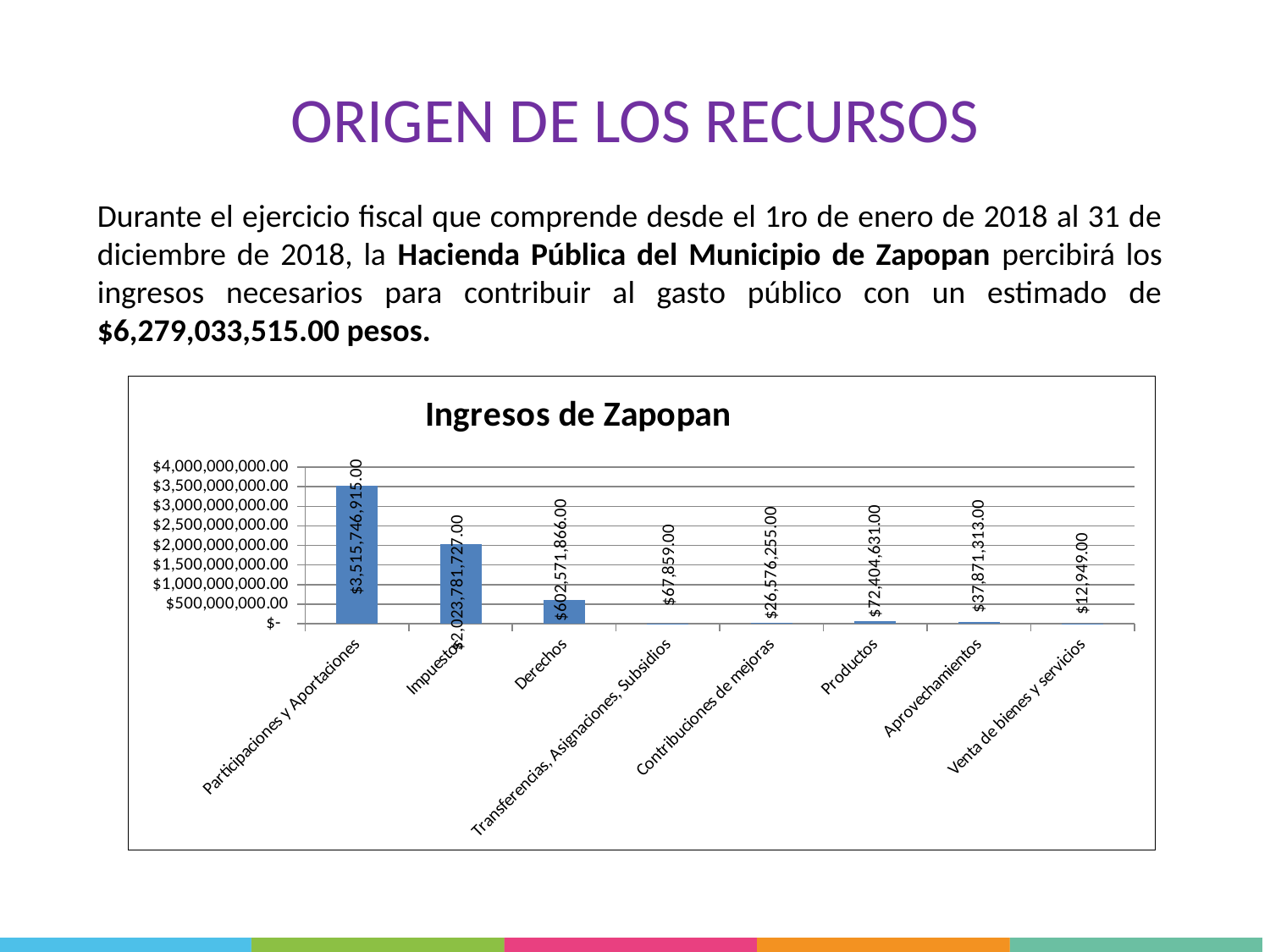
Which is larger in the Ingresos de Zapopan chart, Productos or Aprovechamientos? Productos What is the value for Aprovechamientos in the Ingresos de Zapopan chart? $37,871,313.00 Which category has the lowest value in the Ingresos de Zapopan chart? Venta de bienes y servicios What is the value for Participaciones y Aportaciones in the Ingresos de Zapopan chart? $3,515,746,915.00 What kind of chart is the Ingresos de Zapopan chart? bar chart How many categories are shown in the Ingresos de Zapopan chart? 8 What is the value for Venta de bienes y servicios in the Ingresos de Zapopan chart? $12,949.00 What is the value for Derechos in the Ingresos de Zapopan chart? $602,571,866.00 What is the difference between the values for Derechos and Productos in the Ingresos de Zapopan chart? $530,167,235.00 What is the value for Productos in the Ingresos de Zapopan chart? $72,404,631.00 Is the value for Participaciones y Aportaciones greater or less than $3,000,000,000.00? greater Which category has the highest value in the Ingresos de Zapopan chart? Participaciones y Aportaciones